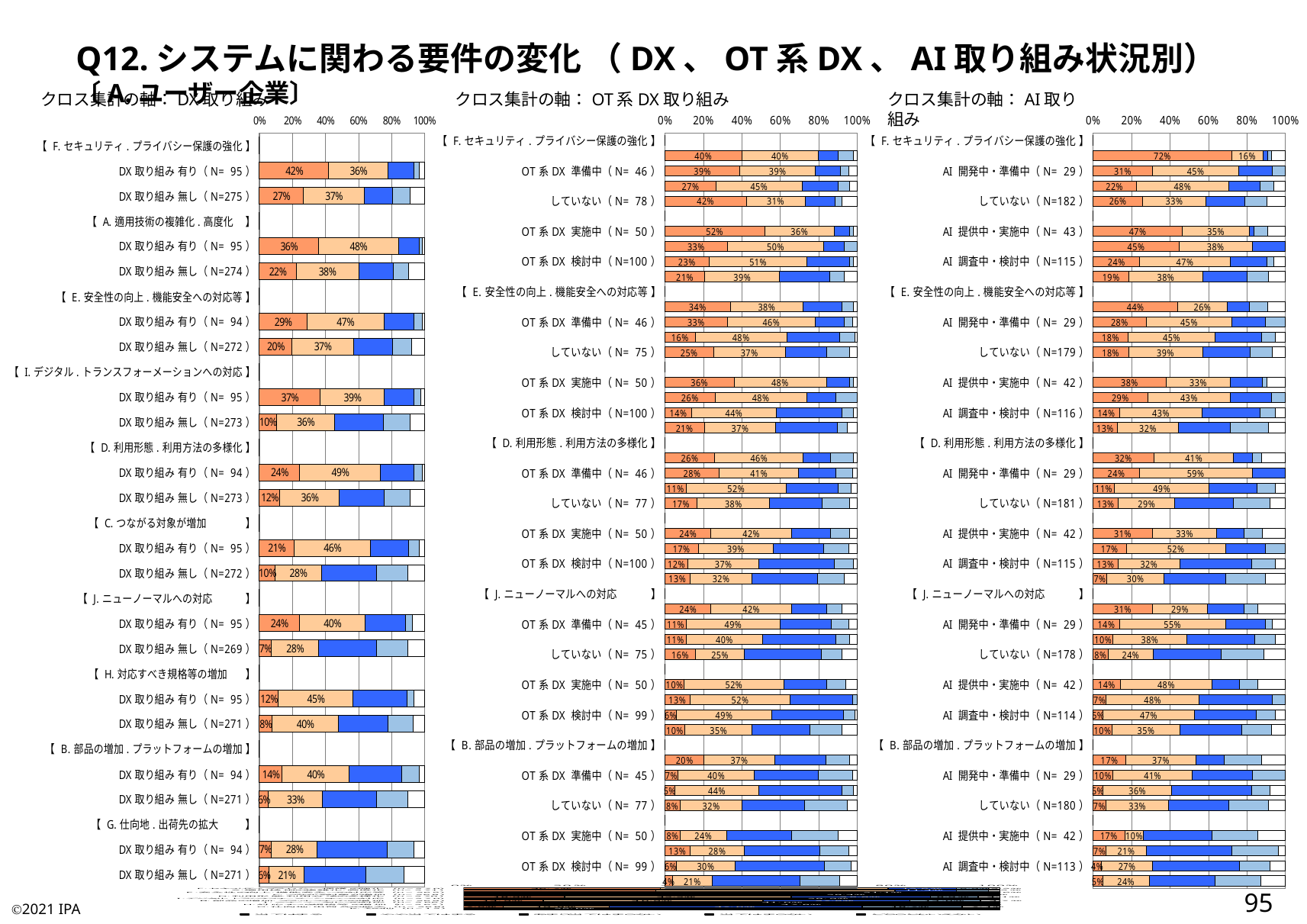
In the left chart (クロス集計の軸: DX取り組み), under F. セキュリティ.プライバシー保護の強化, how many percentage points higher is the first segment for DX取り組み有り (42%) than for DX取り組み無し (27%)? 15 percentage points What is the cross-tabulation axis (クロス集計の軸) of the middle chart? OT系DX取り組み In the left chart (クロス集計の軸: DX取り組み), under G. 仕向地.出荷先の拡大, which has the larger first segment: DX取り組み有り (7%) or DX取り組み無し (5%)? DX取り組み有り What kind of chart is used on this slide? bar chart How many charts are shown on the slide? 3 In the left chart (クロス集計の軸: DX取り組み), what is the first segment value for DX取り組み無し (N=269) under J. ニューノーマルへの対応? 7% In the left chart (クロス集計の軸: DX取り組み), what is the first (leftmost) segment value for DX取り組み有り (N=95) under F. セキュリティ.プライバシー保護の強化? 42% In the left chart (クロス集計の軸: DX取り組み), what is the first segment value for DX取り組み無し (N=275) under F. セキュリティ.プライバシー保護の強化? 27% In the left chart (クロス集計の軸: DX取り組み), which requirement category has the highest first-segment value for DX取り組み有り? F. セキュリティ.プライバシー保護の強化 (42%) In the left chart (クロス集計の軸: DX取り組み), what is the second segment value for DX取り組み有り (N=94) under D. 利用形態.利用方法の多様化? 49% In the left chart, what is the sample size N for DX取り組み無し under F. セキュリティ.プライバシー保護の強化? 275 In the left chart (クロス集計の軸: DX取り組み), what is the second segment value for DX取り組み有り (N=95) under A. 適用技術の複雑化.高度化? 48%